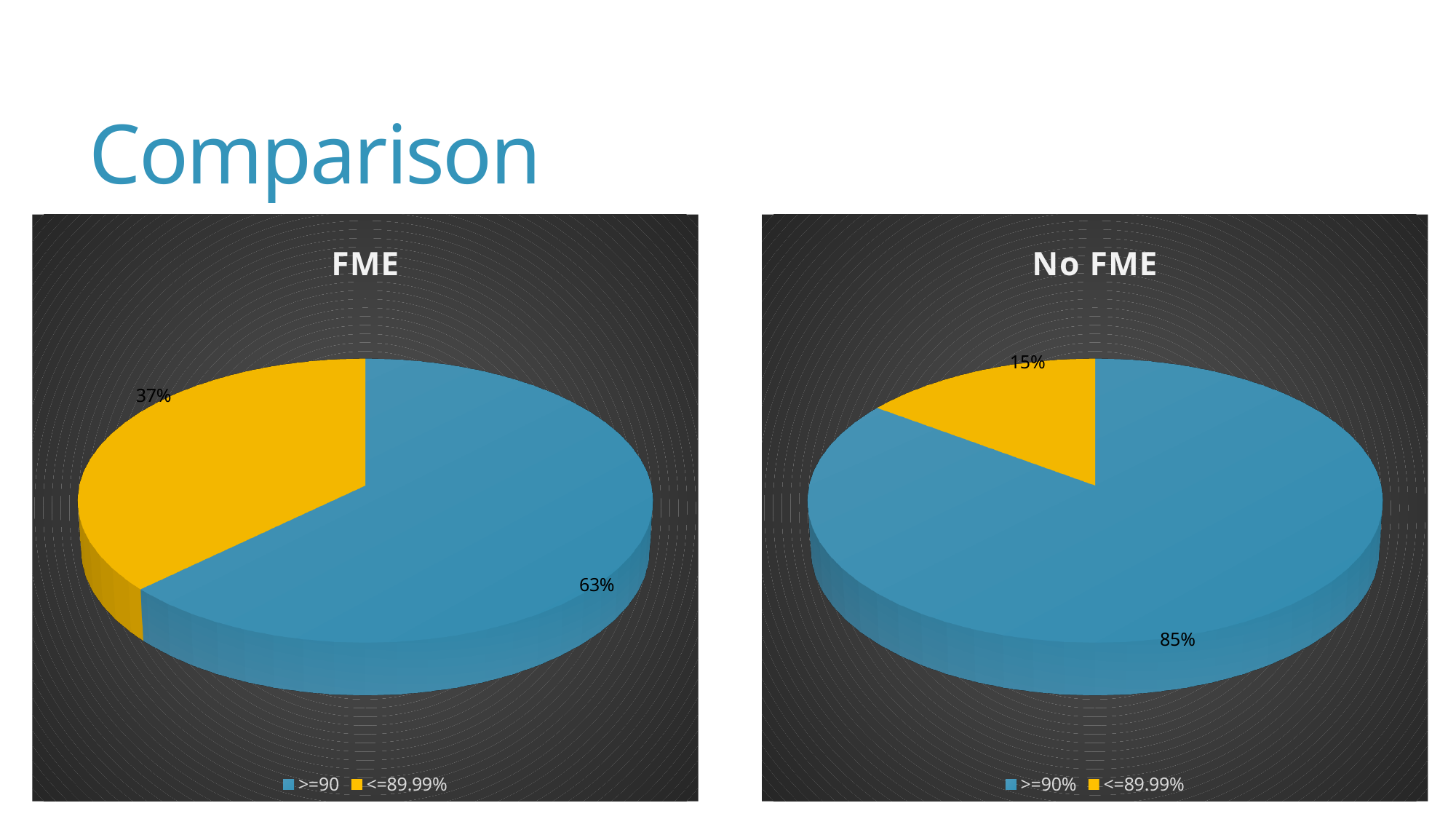
In the FME chart, what share of the pie is the <=89.99% slice? 37% In the No FME chart, what share of the pie is the >=90% slice? 85% In the FME chart, what colour is the <=89.99% slice? Yellow In the FME chart, which slice is the largest? >=90 What kind of chart is the FME chart? Pie chart How many slices does the No FME chart have? 2 In the No FME chart, what share of the pie is the <=89.99% slice? 15% In the FME chart, what is the difference between the >=90 share and the <=89.99% share? 26% In the No FME chart, what is the difference between the >=90% share and the <=89.99% share? 70% In the No FME chart, which slice is the smallest? <=89.99% Which chart has the larger <=89.99% share, FME or No FME? FME